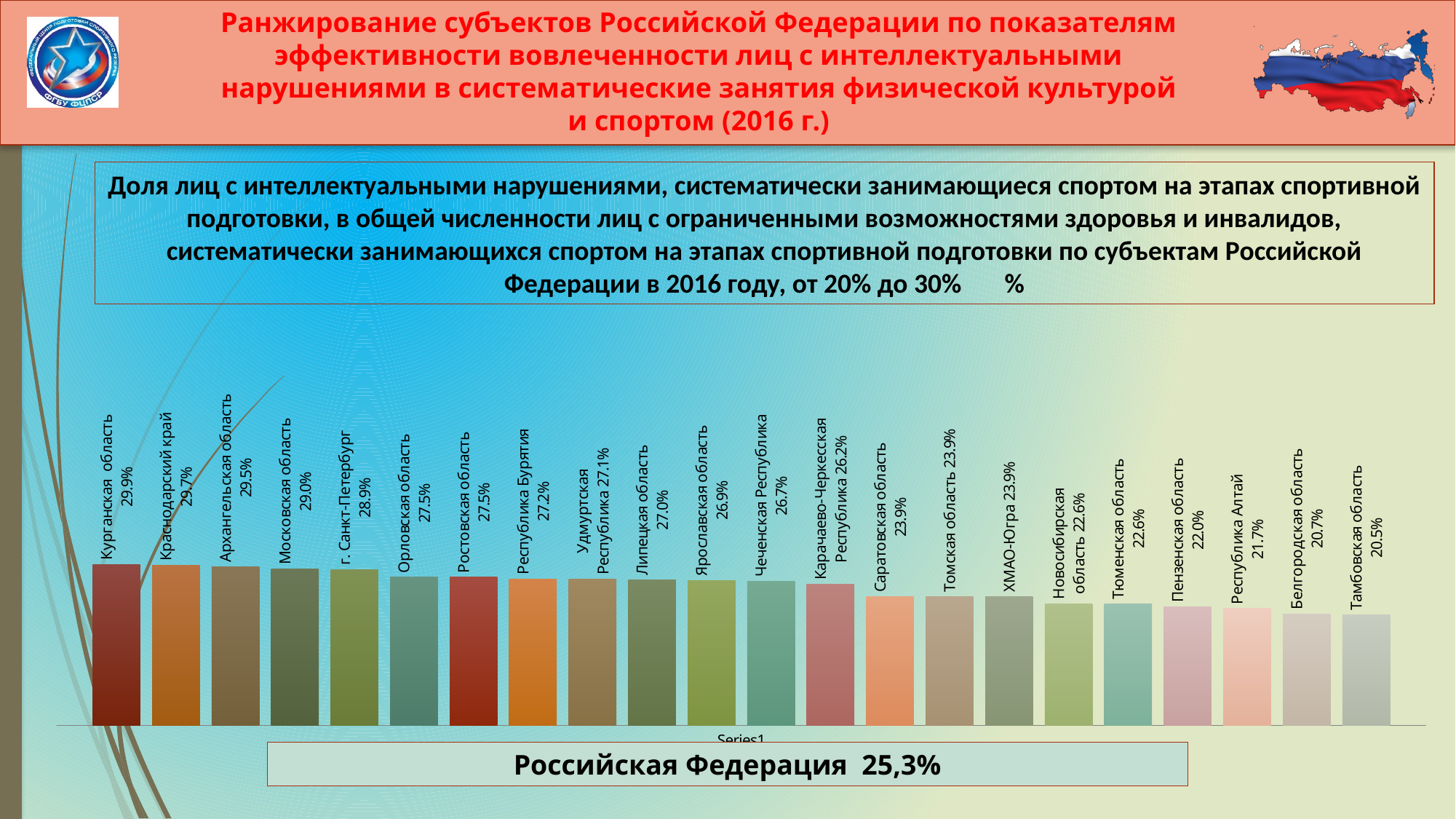
Do the values rise or fall from left to right along the x axis? Fall What is the value for Курганская область? 29.9% What kind of chart is shown on the slide? Bar chart What is the value for Чеченская Республика? 26.7% What is the value for г. Санкт-Петербург? 28.9% How many regions are shown on the chart? 22 What is the difference between the values for Московская область and Саратовская область? 5.1% Which region has the lowest value on the chart? Тамбовская область What is the difference between the values for Курганская область and Тамбовская область? 9.4% Which is larger, the value for Липецкая область or the value for Пензенская область? Липецкая область Which region has the highest value on the chart? Курганская область What is the value for Республика Алтай? 21.7%